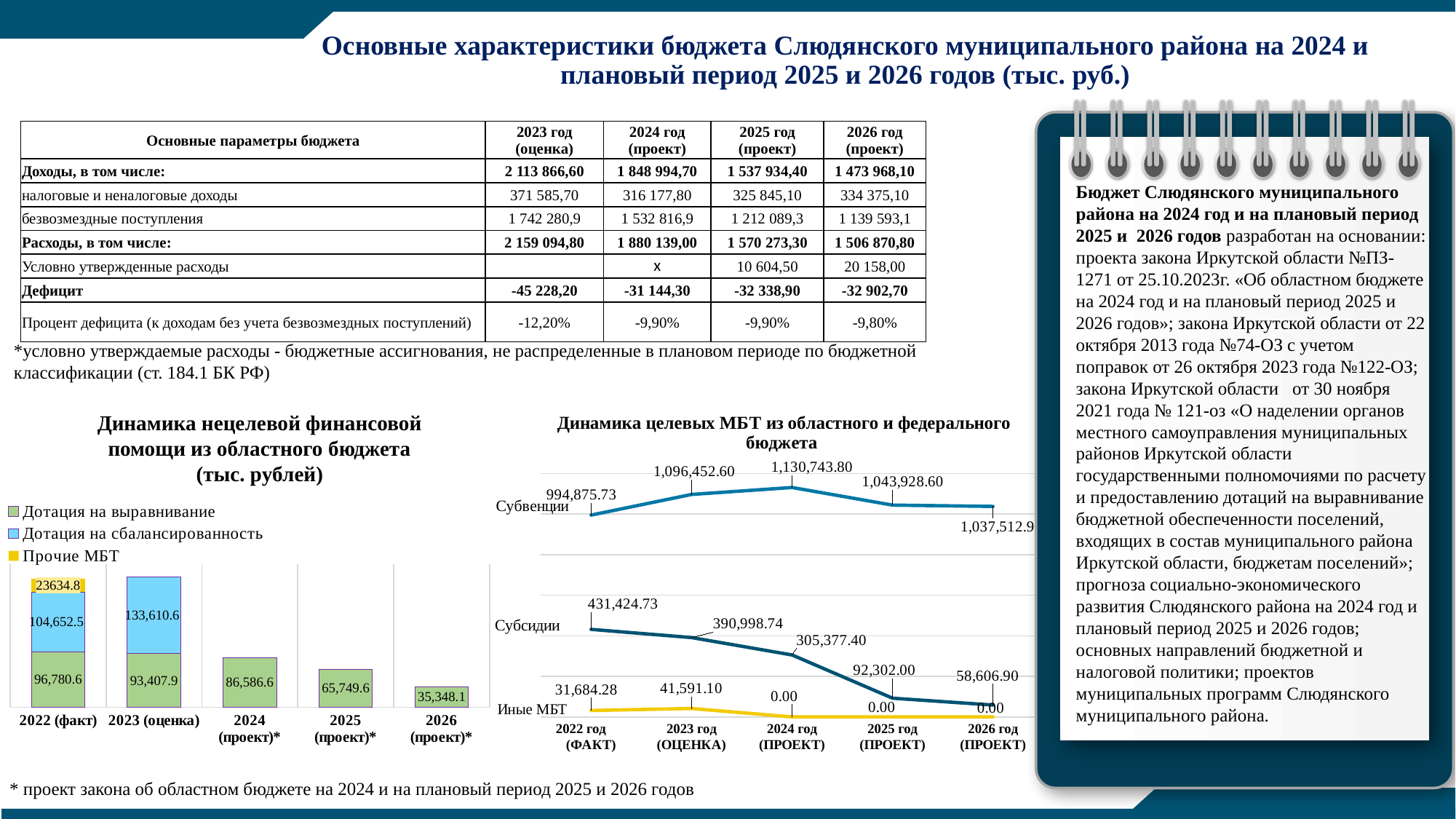
In the chart 'Динамика целевых МБТ из областного и федерального бюджета', which year has the highest value of 'Субвенции'? 2024 год (ПРОЕКТ) In the chart 'Динамика нецелевой финансовой помощи из областного бюджета', what is the total of the stacked bar for 2023 (оценка)? 227,018.5 In the chart 'Динамика нецелевой финансовой помощи из областного бюджета', which year has the lowest value of 'Дотация на выравнивание'? 2026 (проект)* In the chart 'Динамика целевых МБТ из областного и федерального бюджета', what is the value of 'Субсидии' for 2026 год (ПРОЕКТ)? 58,606.90 In the chart 'Динамика нецелевой финансовой помощи из областного бюджета', how many series does the legend list? 3 In the chart 'Динамика целевых МБТ из областного и федерального бюджета', what kind of chart is it? line chart In the chart 'Динамика нецелевой финансовой помощи из областного бюджета', does the value of 'Дотация на выравнивание' rise or fall from 2022 to 2026? fall In the chart 'Динамика целевых МБТ из областного и федерального бюджета', what is the value of 'Субвенции' for 2024 год (ПРОЕКТ)? 1,130,743.80 In the chart 'Динамика нецелевой финансовой помощи из областного бюджета', what is the value of 'Прочие МБТ' for 2022 (факт)? 23634.8 In the chart 'Динамика целевых МБТ из областного и федерального бюджета', what is the difference between 'Субсидии' in 2022 год (ФАКТ) and 2023 год (ОЦЕНКА)? 40,425.99 In the chart 'Динамика нецелевой финансовой помощи из областного бюджета', what is the value of 'Дотация на сбалансированность' for 2023 (оценка)? 133,610.6 In the chart 'Динамика нецелевой финансовой помощи из областного бюджета', what is the value of 'Дотация на выравнивание' for 2024 (проект)*? 86,586.6